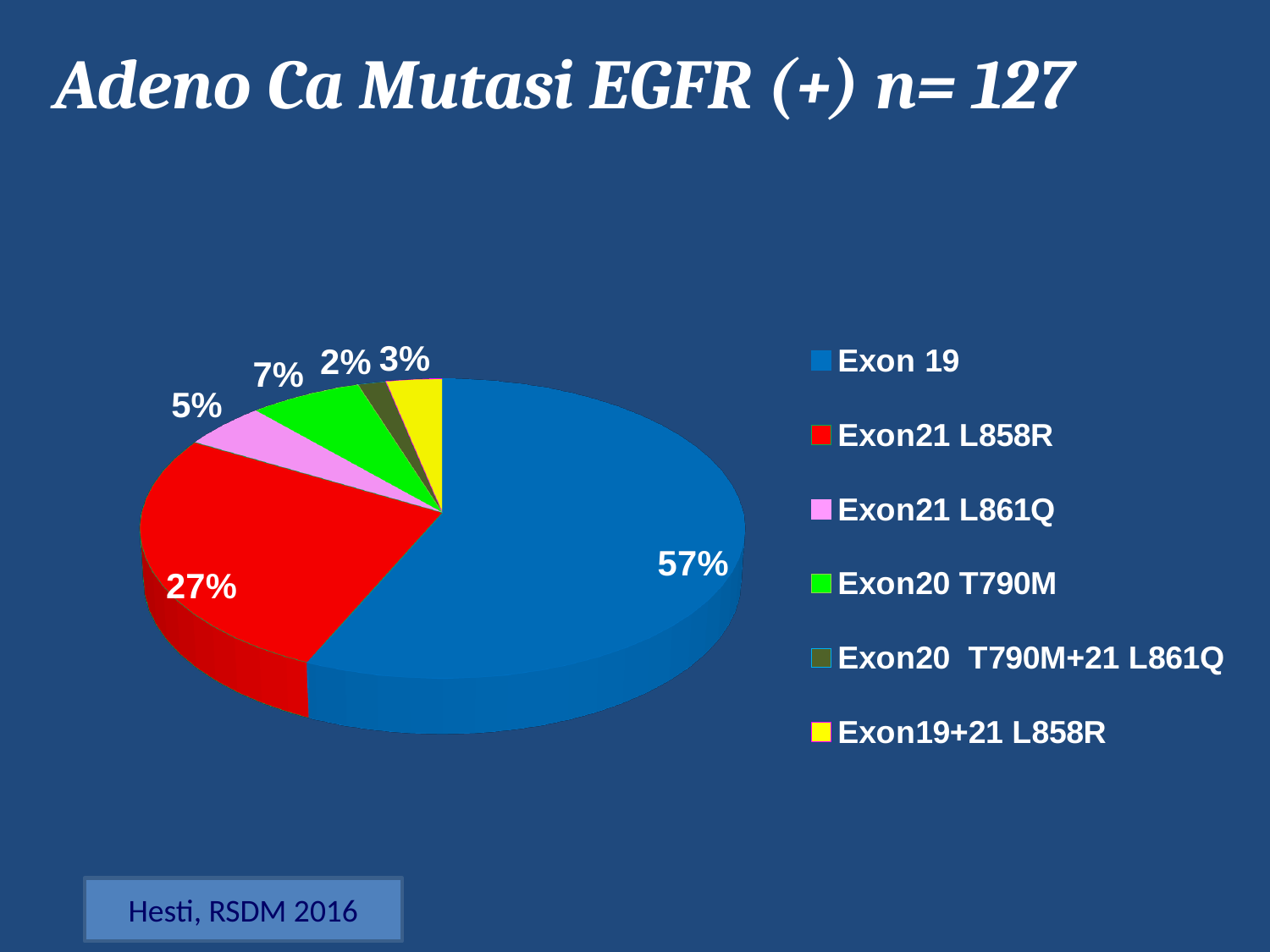
What percentage of the pie is Exon19+21 L858R? 3% How many categories does the legend list? 6 What is the difference in percentage points between Exon 19 and Exon21 L858R? 30 What type of chart is shown on the slide? Pie chart What percentage of the pie is Exon20 T790M? 7% Which is larger, the share for Exon20 T790M or the share for Exon21 L861Q? Exon20 T790M What percentage of the pie is Exon21 L858R? 27% What percentage of the pie is Exon21 L861Q? 5% Which category has the smallest share of the pie? Exon20 T790M+21 L861Q Which category has the largest share of the pie? Exon 19 What percentage of the pie is Exon20 T790M+21 L861Q? 2% What percentage of the pie is Exon 19? 57%